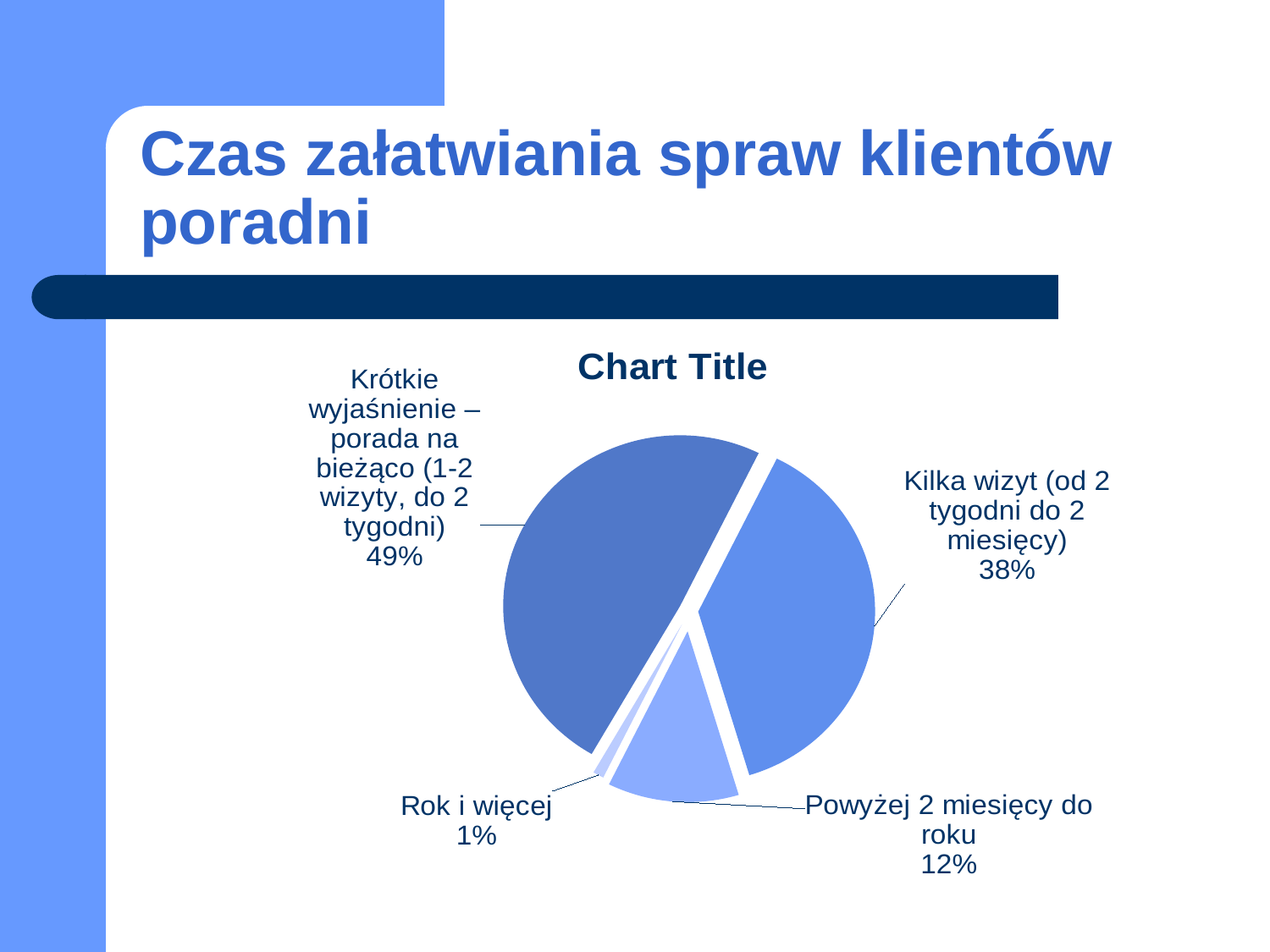
What percentage of the pie is 'Powyżej 2 miesięcy do roku'? 12% Which is larger: the share for 'Powyżej 2 miesięcy do roku' or the share for 'Rok i więcej'? Powyżej 2 miesięcy do roku What percentage of the pie is 'Kilka wizyt (od 2 tygodni do 2 miesięcy)'? 38% What kind of chart is shown on the slide? pie chart What percentage of the pie is 'Rok i więcej'? 1% Which category has the largest share of the pie? Krótkie wyjaśnienie – porada na bieżąco (1-2 wizyty, do 2 tygodni) What is the combined share of 'Powyżej 2 miesięcy do roku' and 'Rok i więcej'? 13% What is the title shown above the pie chart? Chart Title What is the difference in percentage points between 'Krótkie wyjaśnienie – porada na bieżąco' and 'Kilka wizyt (od 2 tygodni do 2 miesięcy)'? 11 percentage points How many slices does the pie chart have? 4 What percentage of the pie is 'Krótkie wyjaśnienie – porada na bieżąco (1-2 wizyty, do 2 tygodni)'? 49% Which category has the smallest share of the pie? Rok i więcej